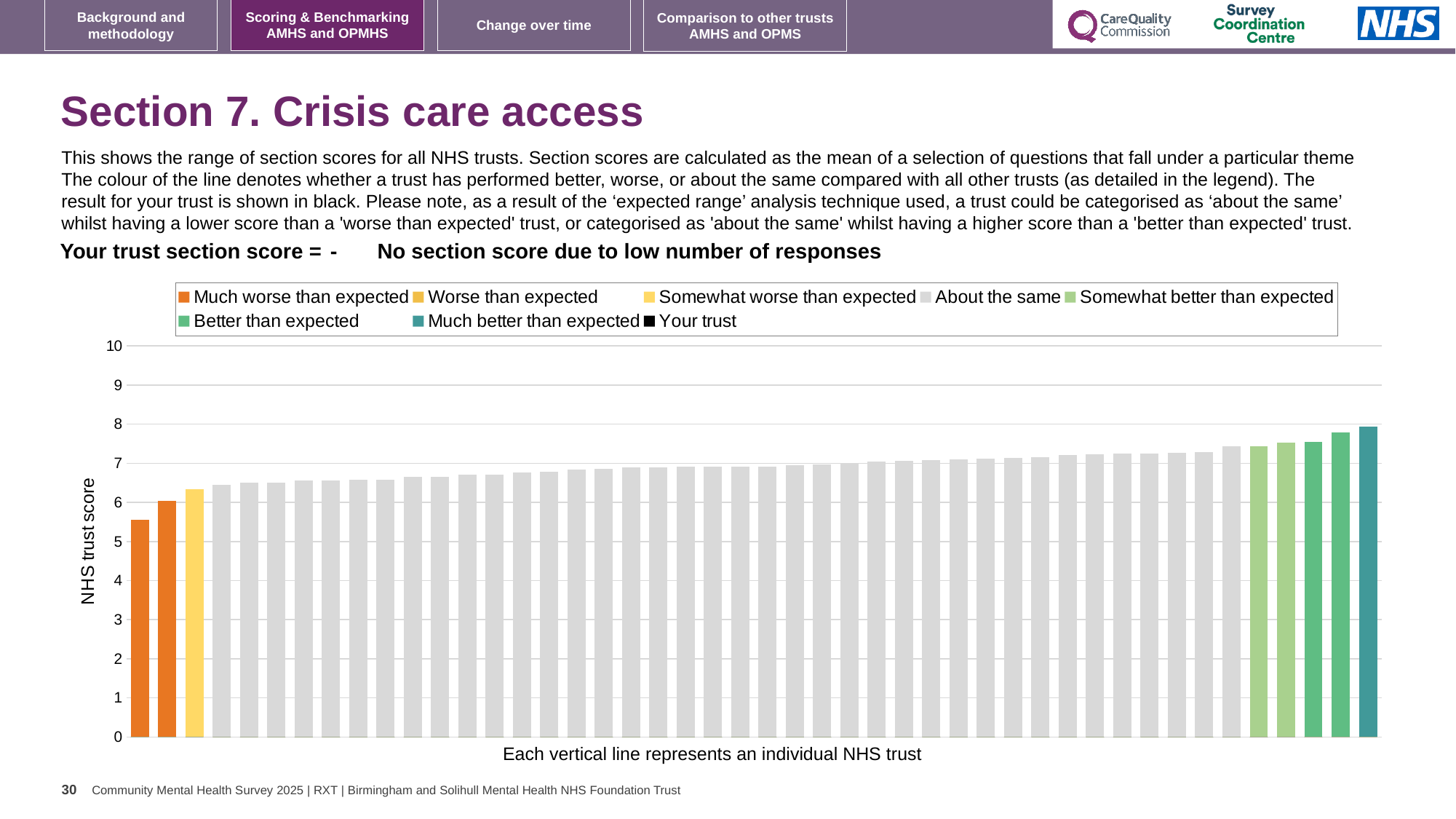
Is the value of the rightmost bar greater or less than 7? greater How many bars are coloured as 'Much better than expected'? 1 Which legend category does the highest bar on the chart belong to? Much better than expected How many entries does the chart legend list? 8 How many bars are coloured as 'Somewhat better than expected'? 2 What is the label on the vertical axis of the chart? NHS trust score Which legend category does the lowest bar on the chart belong to? Much worse than expected What kind of chart is shown on the slide? Bar chart Is the value of the tallest grey 'About the same' bar greater or less than 8? less How many bars are coloured as 'Much worse than expected'? 2 Is the value of the leftmost bar greater or less than 6? less Do the bar values rise or fall from left to right across the chart? Rise